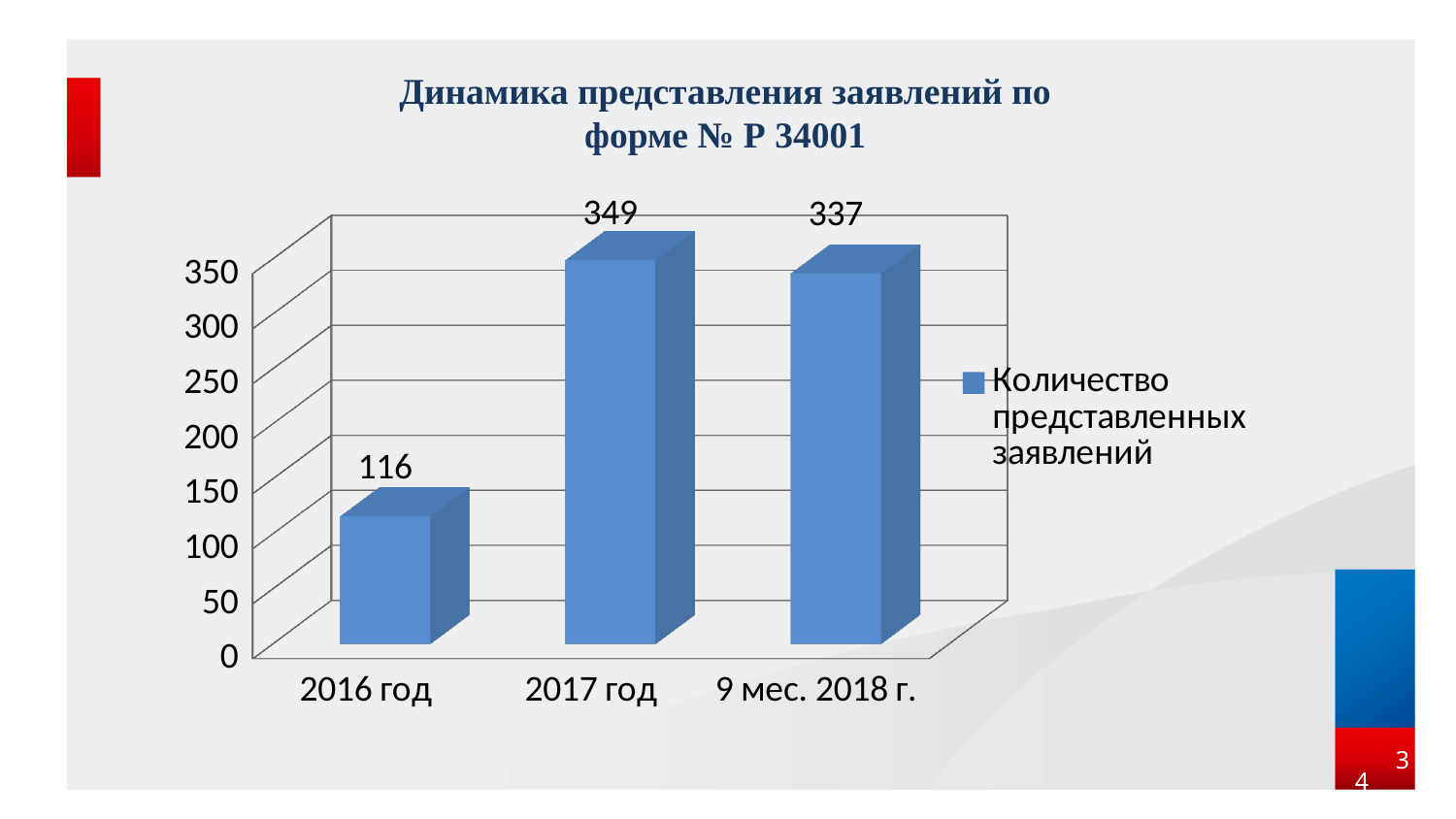
What is the difference between the values for 2017 год and 2016 год? 233 How many series does the legend list? 1 Which category has the lowest value? 2016 год What is the value for 2017 год? 349 What kind of chart is shown on the slide? bar chart What is the value for 2016 год? 116 What is the value for 9 мес. 2018 г.? 337 What is the difference between the values for 2017 год and 9 мес. 2018 г.? 12 Which is larger, the value for 2016 год or the value for 9 мес. 2018 г.? 9 мес. 2018 г. What is the legend entry for the series? Количество представленных заявлений Which category has the highest value? 2017 год How many categories are shown on the x axis? 3